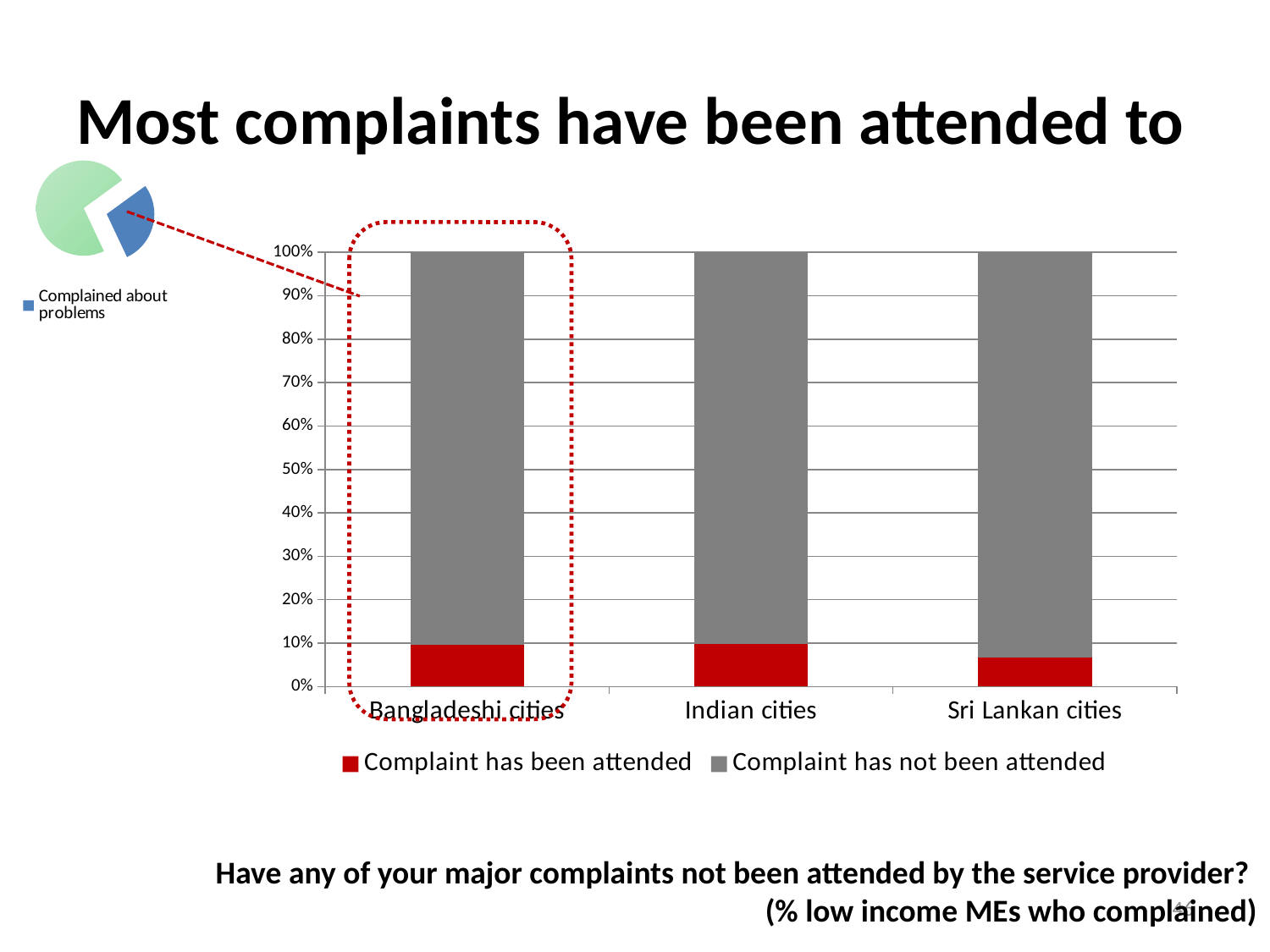
In the main chart, what is the total height of the stacked bar for Bangladeshi cities? 100% In the main chart, is the 'Complaint has not been attended' value for Indian cities greater or less than 80%? greater In the main chart, is the 'Complaint has been attended' value for Sri Lankan cities greater or less than 10%? less How many city categories are shown on the x axis of the main chart? 3 In the main chart, which category has the smallest 'Complaint has been attended' segment? Sri Lankan cities What kind of chart is the main chart on the slide? Stacked bar chart In the main chart, is the 'Complaint has not been attended' value for Sri Lankan cities greater or less than 90%? greater Which category in the main chart is highlighted with a red dotted outline? Bangladeshi cities In the main chart, which has the larger 'Complaint has been attended' segment: Indian cities or Sri Lankan cities? Indian cities How many series does the legend of the main chart list? 2 In the main chart, which category has the largest 'Complaint has not been attended' segment? Sri Lankan cities In the main chart, what colour represents 'Complaint has been attended'? Red